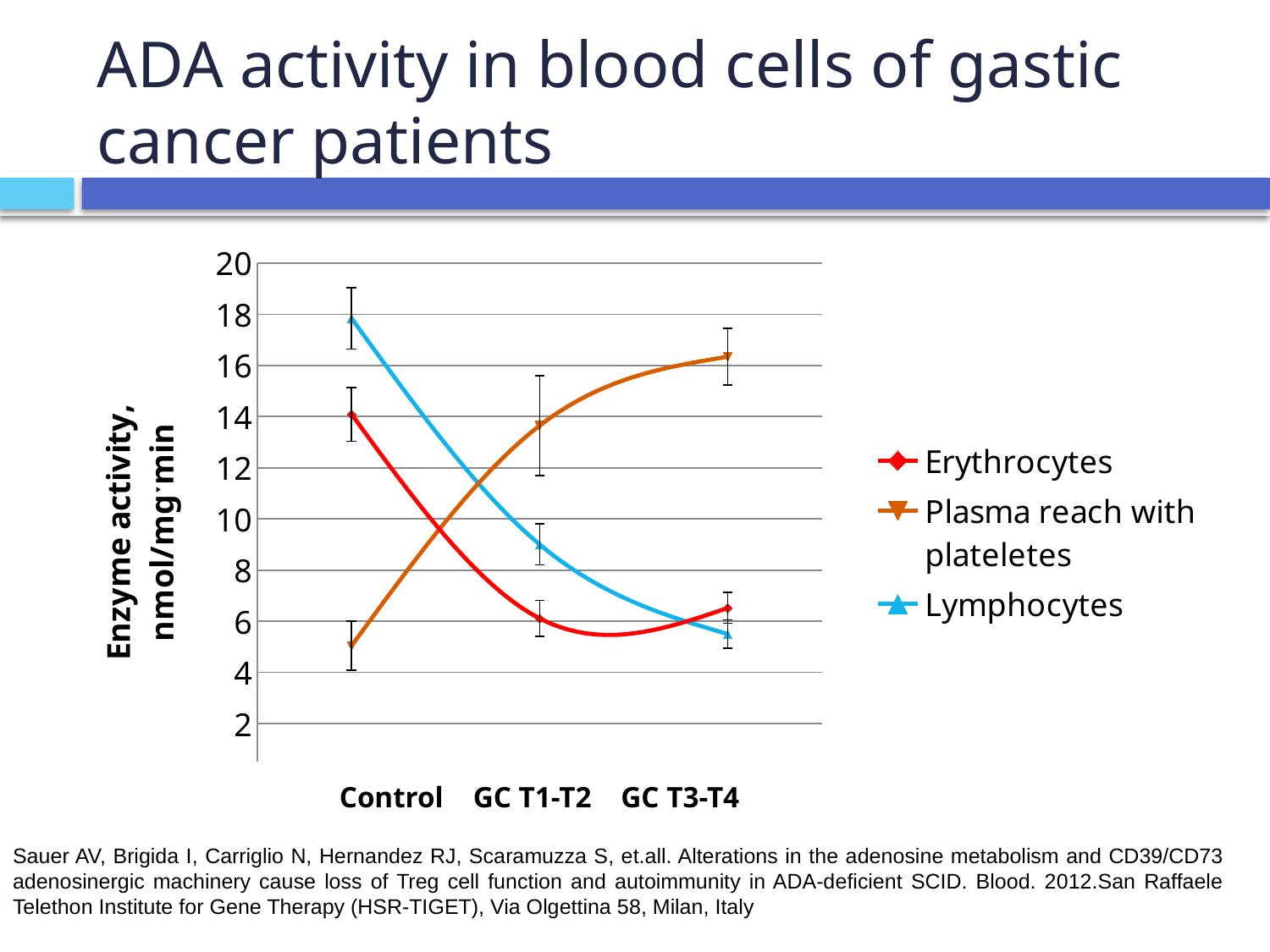
Is the Erythrocytes value at GC T1-T2 greater or less than 8? less Which series has the highest value at Control? Lymphocytes Do the Plasma reach with plateletes values rise or fall from Control to GC T3-T4? rise How many categories are shown on the x axis? 3 Do the Lymphocytes values rise or fall from Control to GC T3-T4? fall Which series has the highest value at GC T3-T4? Plasma reach with plateletes How many series does the legend list? 3 Which series has the lowest value at Control? Plasma reach with plateletes Is the Lymphocytes value at Control greater or less than 16? greater What is the label of the y axis? Enzyme activity, nmol/mg·min Is the Plasma reach with plateletes value at Control greater or less than 6? less What kind of chart is shown on the slide? line chart